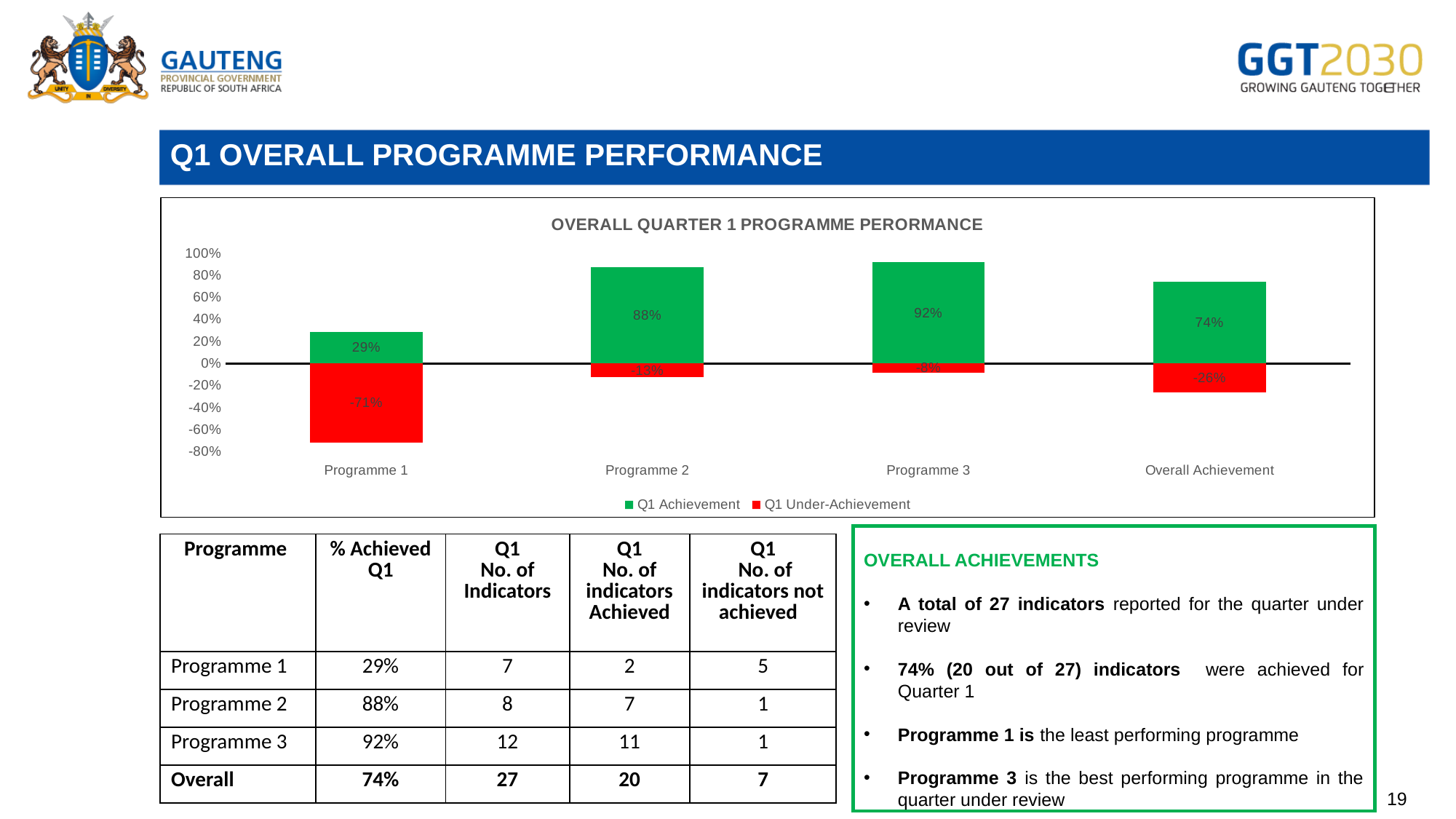
What kind of chart is shown on the slide? Bar chart What is the Q1 Under-Achievement value for Programme 2? -13% What is the Q1 Achievement value for Programme 2? 88% What is the Q1 Achievement value for Overall Achievement? 74% What is the Q1 Under-Achievement value for Programme 1? -71% Which category has the lowest Q1 Achievement value? Programme 1 What colour represents the Q1 Under-Achievement series in the chart? Red How many series does the chart legend list? 2 Which is larger, the Q1 Achievement value for Programme 2 or for Overall Achievement? Programme 2 Which category has the highest Q1 Achievement value? Programme 3 How many categories are shown on the x axis of the chart? 4 What is the difference between the Q1 Achievement values for Programme 3 and Programme 1? 63%